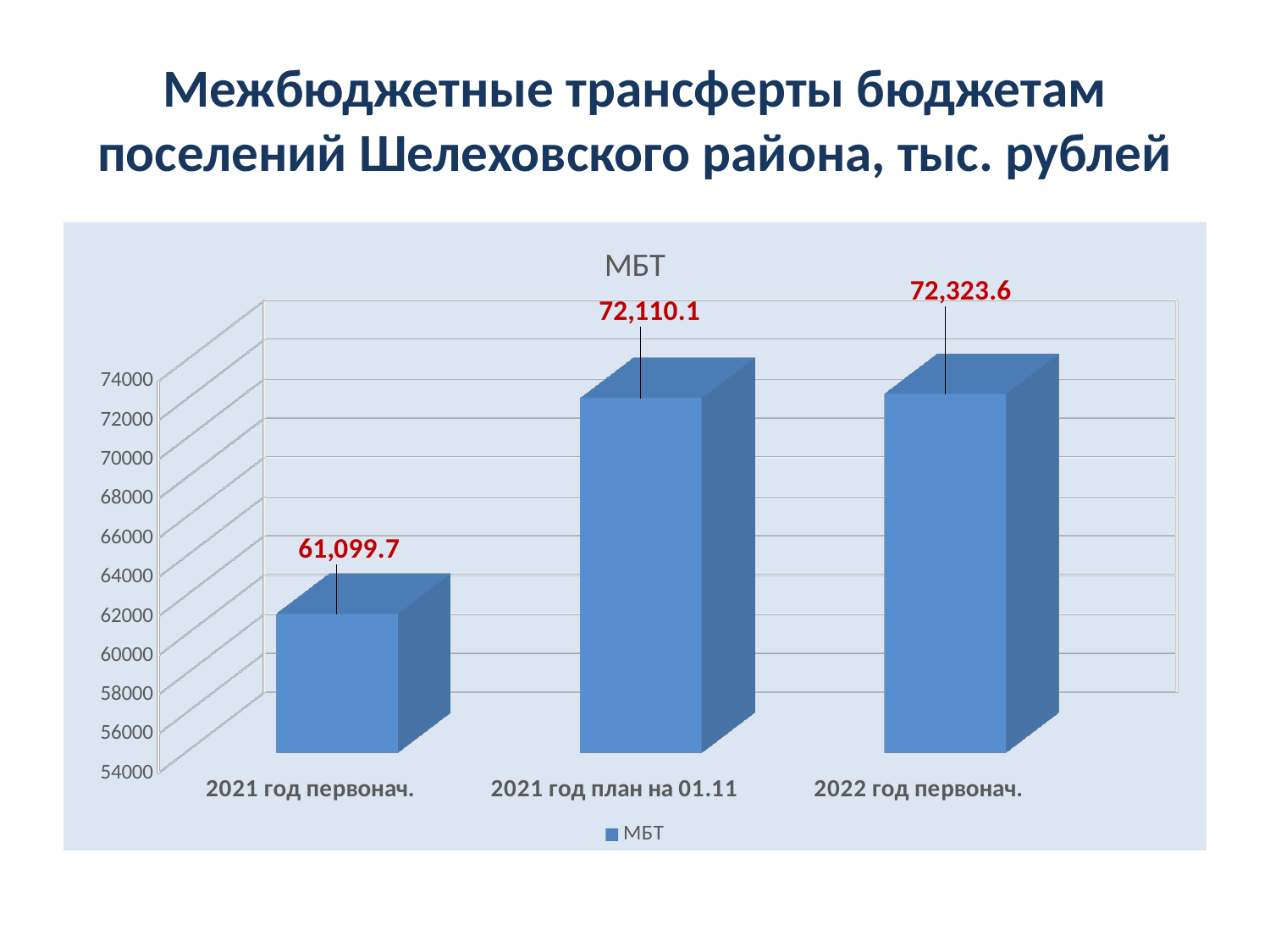
What is the value for "2021 год первонач."? 61,099.7 What is the value for "2021 год план на 01.11"? 72,110.1 Which category has the highest value? 2022 год первонач. What is the value for "2022 год первонач."? 72,323.6 How many series does the legend list? 1 What is the difference between the values for "2021 год план на 01.11" and "2021 год первонач."? 11,010.4 What is the difference between the values for "2022 год первонач." and "2021 год план на 01.11"? 213.5 Which category has the lowest value? 2021 год первонач. What kind of chart is shown on the slide? bar chart Is the value for "2021 год первонач." greater or less than 64000? less How many categories are shown on the x axis? 3 Which is larger, the value for "2021 год план на 01.11" or the value for "2022 год первонач."? 2022 год первонач.